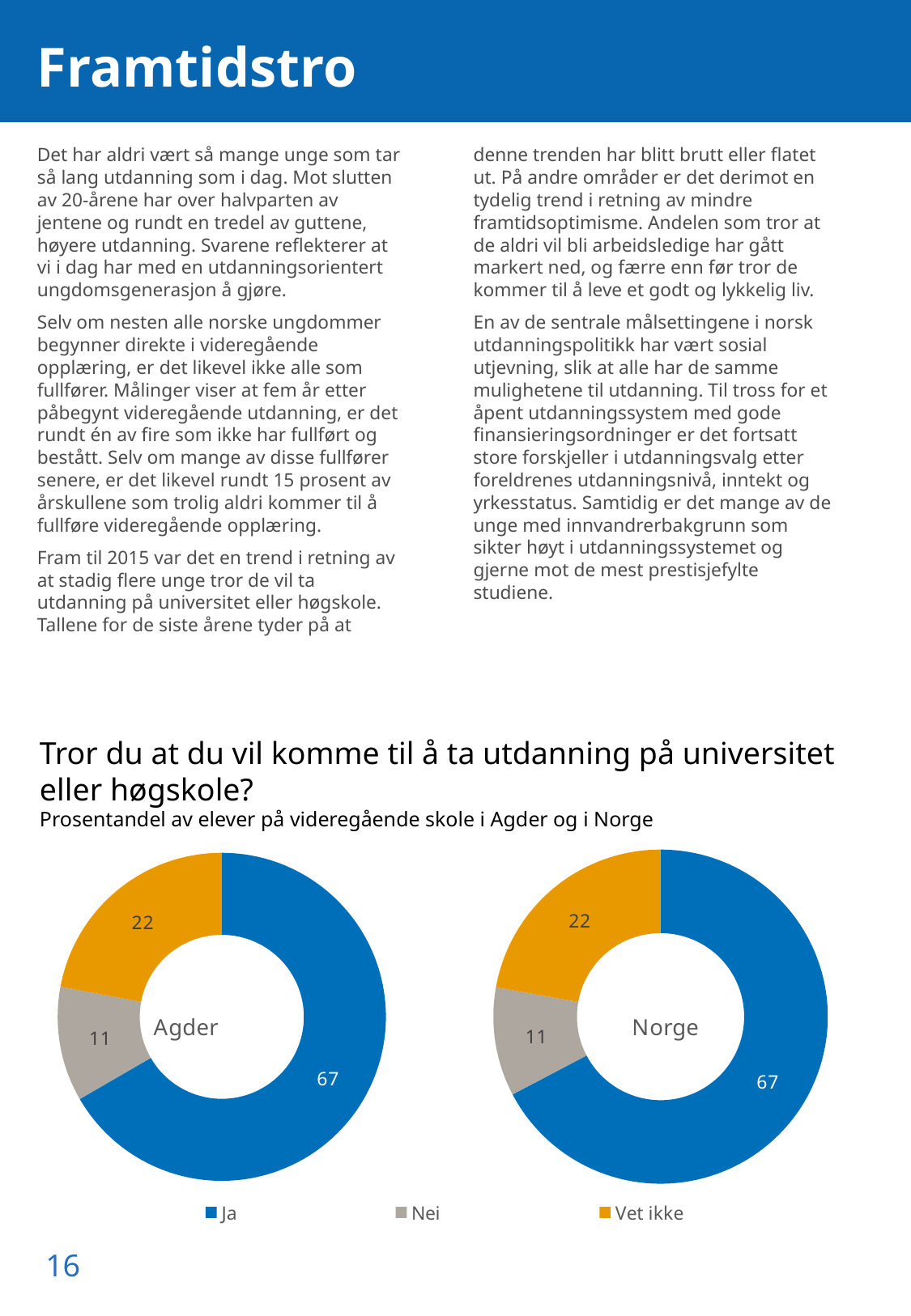
In the Agder chart, what is the value for "Nei"? 11 How many entries does the legend list? 3 In the Agder chart, which category has the smallest share? Nei How many categories does the Agder chart show? 3 What kind of chart is the Norge chart? Donut (pie) chart In the Norge chart, what is the value for "Vet ikke"? 22 In the Agder chart, which is larger, "Vet ikke" or "Nei"? Vet ikke In the Norge chart, which category has the largest share? Ja In the Norge chart, what is the difference between the values for "Ja" and "Vet ikke"? 45 In the Norge chart, what is the difference between the values for "Vet ikke" and "Nei"? 11 In the Agder chart, what is the value for "Ja"? 67 Which colour represents "Ja" in the charts? Blue